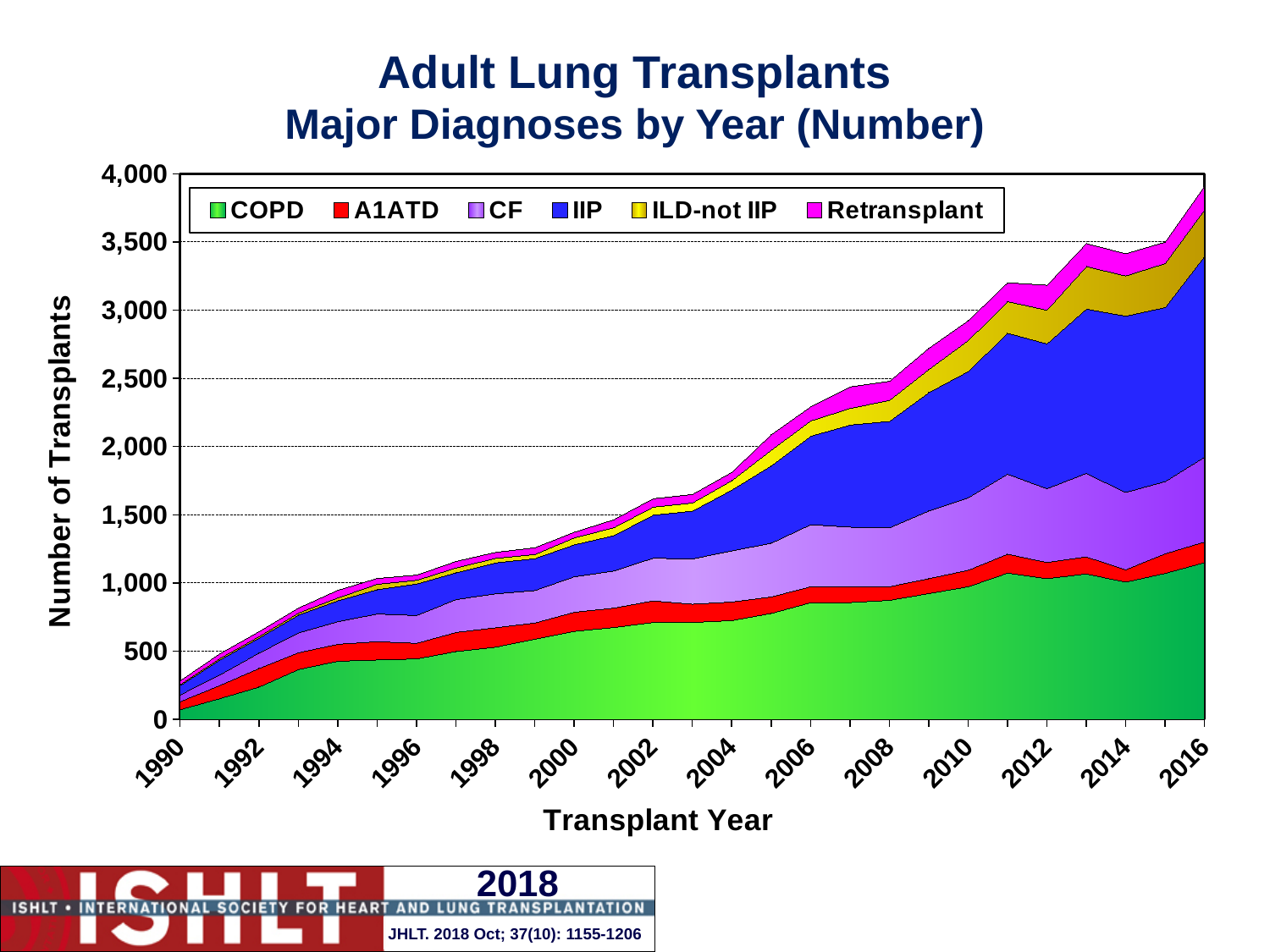
Which transplant year has the highest total number of transplants? 2016 Which transplant year has the lowest total number of transplants? 1990 Is the total number of transplants in 2008 greater or less than 2,000? greater Which diagnosis series is shown in green? COPD Which year has the larger total number of transplants, 2000 or 2010? 2010 Is the total number of transplants in 1990 greater or less than 500? less What is the title of the chart? Adult Lung Transplants Major Diagnoses by Year (Number) What kind of chart is shown on the slide? stacked area chart Does the total number of transplants rise or fall from 1990 to 2016? rise How many diagnosis series does the legend list? 6 Is the total number of transplants in 2016 greater or less than 3,500? greater